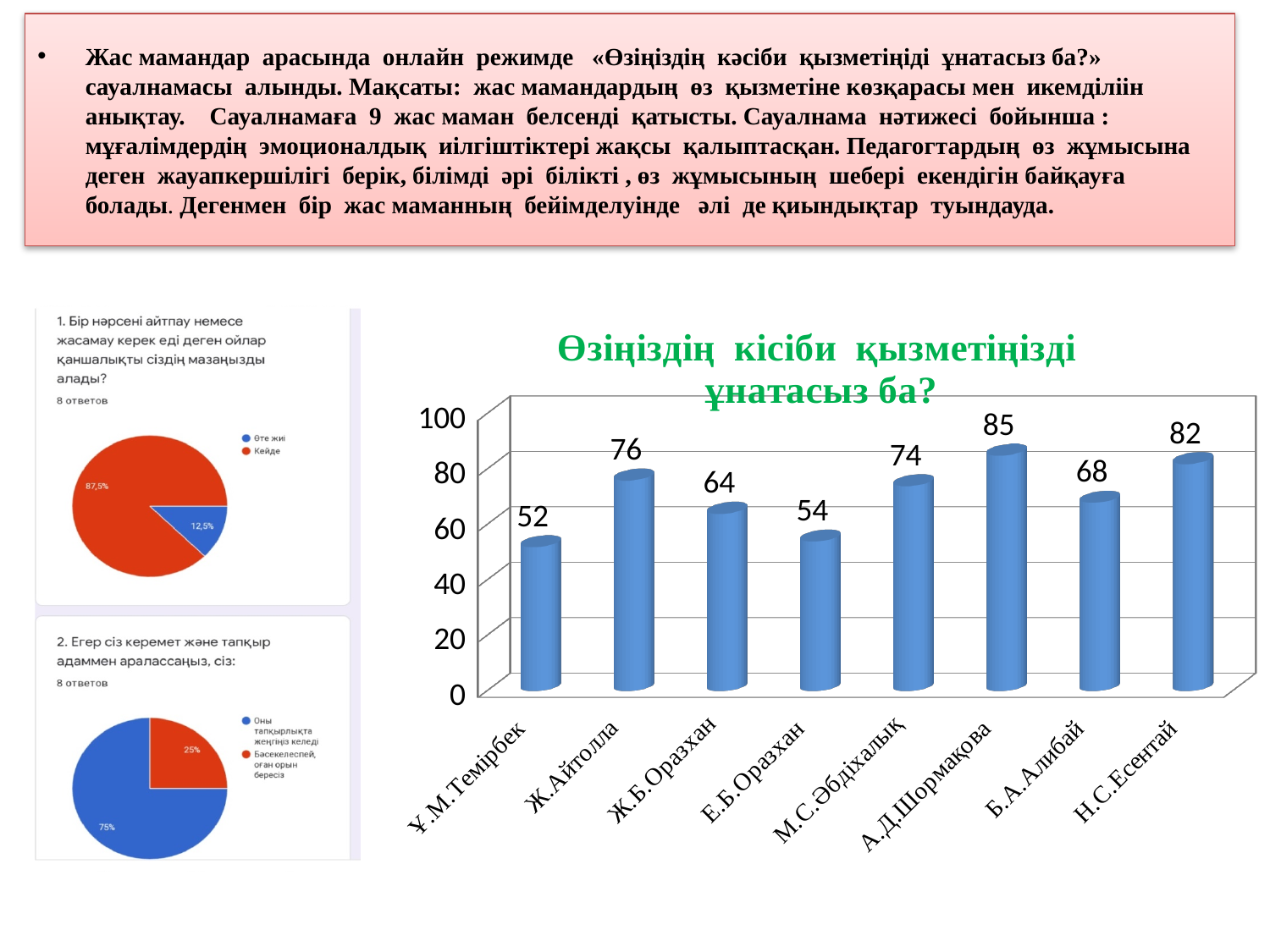
In the bar chart titled "Өзіңіздің кісіби қызметіңізді ұнатасыз ба?", which category has the highest value? А.Д.Шормақова What kind of chart is the chart titled "Өзіңіздің кісіби қызметіңізді ұнатасыз ба?"? bar chart In the bar chart titled "Өзіңіздің кісіби қызметіңізді ұнатасыз ба?", which category has the lowest value? Ұ.М.Темірбек In the bar chart titled "Өзіңіздің кісіби қызметіңізді ұнатасыз ба?", how many categories are shown on the x axis? 8 In the bar chart titled "Өзіңіздің кісіби қызметіңізді ұнатасыз ба?", what is the value for А.Д.Шормақова? 85 In the bar chart titled "Өзіңіздің кісіби қызметіңізді ұнатасыз ба?", which is larger: the value for Ж.Айтолла or the value for Ж.Б.Оразхан? Ж.Айтолла In the bar chart titled "Өзіңіздің кісіби қызметіңізді ұнатасыз ба?", what is the value for Б.А.Алибай? 68 In the bar chart titled "Өзіңіздің кісіби қызметіңізді ұнатасыз ба?", what is the value for Ұ.М.Темірбек? 52 In the bottom pie chart on the left side of the slide, what is the largest slice's share? 75% In the top pie chart on the left side of the slide, what share does the "Кейде" slice have? 87,5% In the bar chart titled "Өзіңіздің кісіби қызметіңізді ұнатасыз ба?", what is the difference between the values for Н.С.Есентай and Е.Б.Оразхан? 28 In the bar chart titled "Өзіңіздің кісіби қызметіңізді ұнатасыз ба?", what is the highest tick value shown on the vertical axis? 100